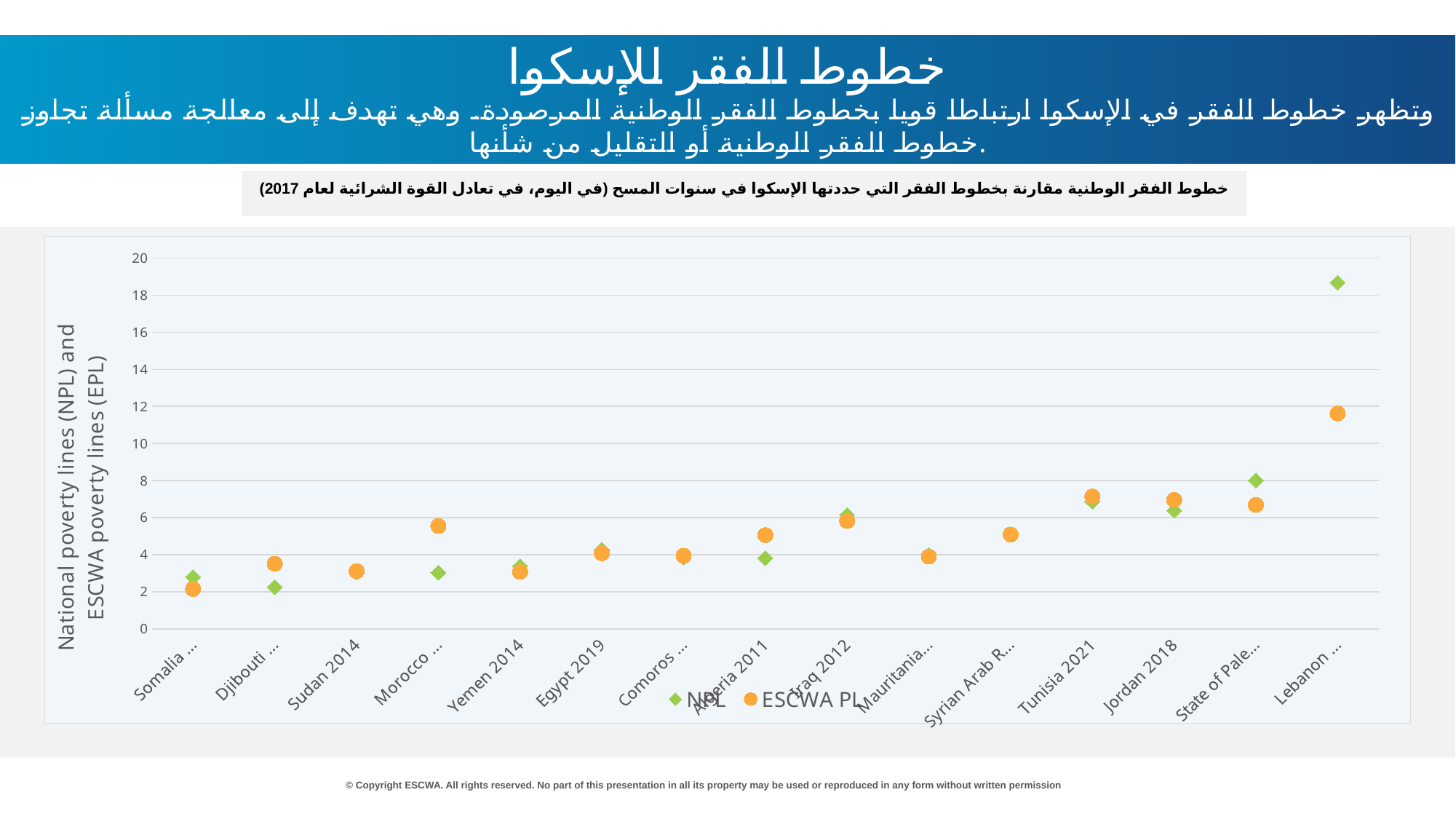
How many series does the legend list? 2 Which country has the lowest ESCWA PL value? Somalia Is the ESCWA PL value for Lebanon greater or less than 10? greater Do the ESCWA PL values generally rise or fall moving from left to right along the x axis? rise What kind of chart is shown on the slide? Scatter (dot) chart Which country has the highest ESCWA PL value? Lebanon What are the two series named in the legend? NPL and ESCWA PL Which country has the highest NPL value? Lebanon Is the ESCWA PL value for Sudan 2014 greater or less than 4? less How many countries are plotted along the x axis? 15 Is the NPL value for Lebanon greater or less than 16? greater For Morocco, which is larger: the NPL value or the ESCWA PL value? ESCWA PL